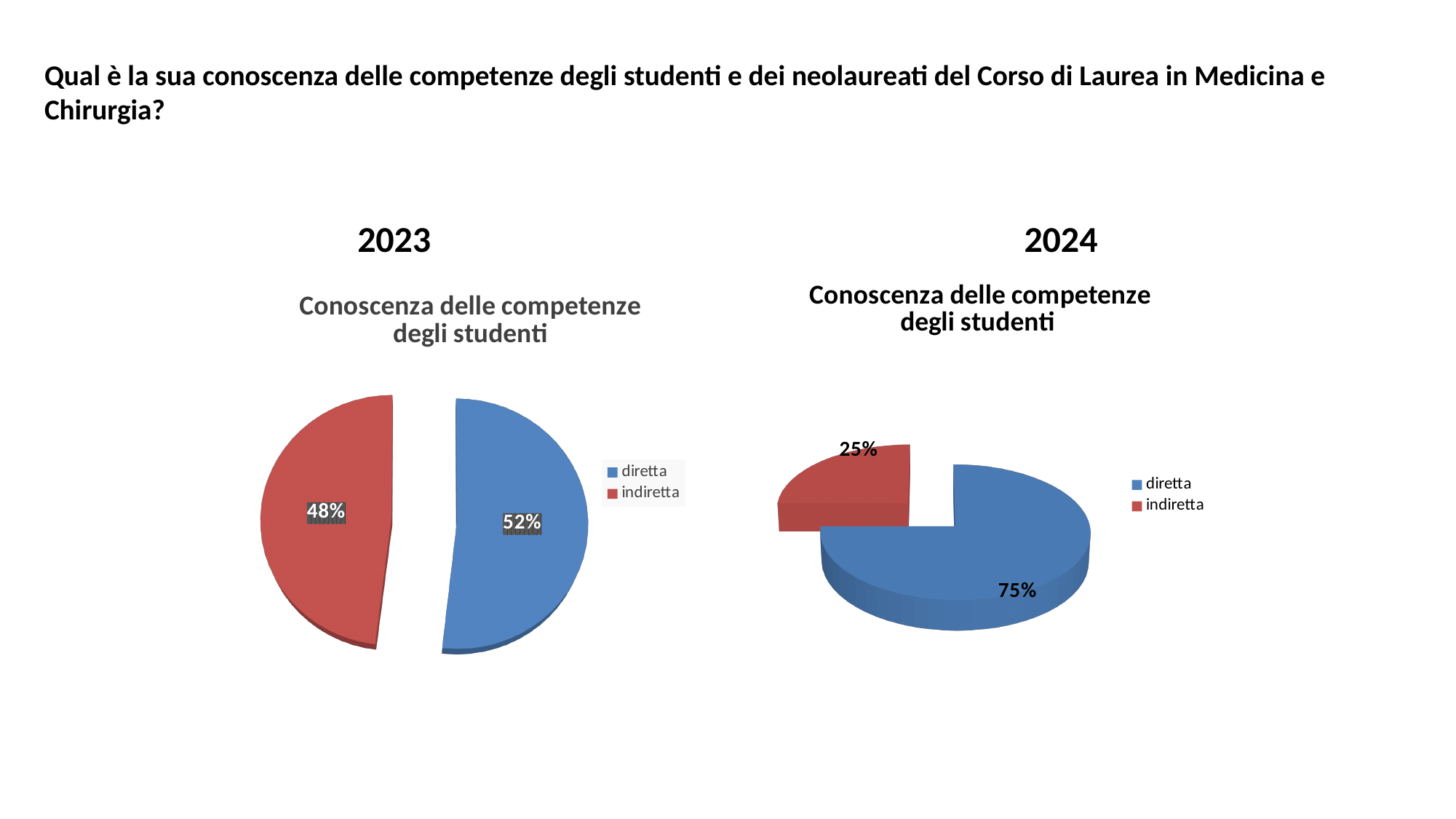
In the 2023 chart, what is the value for 'diretta'? 52% How many entries does the legend of the 2024 chart list? 2 In the 2024 chart, what is the value for 'indiretta'? 25% In the 2023 chart, what is the value for 'indiretta'? 48% In the 2024 chart, which category has the smallest slice? indiretta In the 2024 chart, what is the difference between 'diretta' and 'indiretta'? 50% In the 2024 chart, which category has the largest slice? diretta In the 2023 chart, what colour is the 'indiretta' slice? red What kind of chart is the 2023 chart? pie chart In the 2024 chart, what is the value for 'diretta'? 75% In the 2024 chart, which is larger, 'diretta' or 'indiretta'? diretta In the 2023 chart, what is the difference between 'diretta' and 'indiretta'? 4%